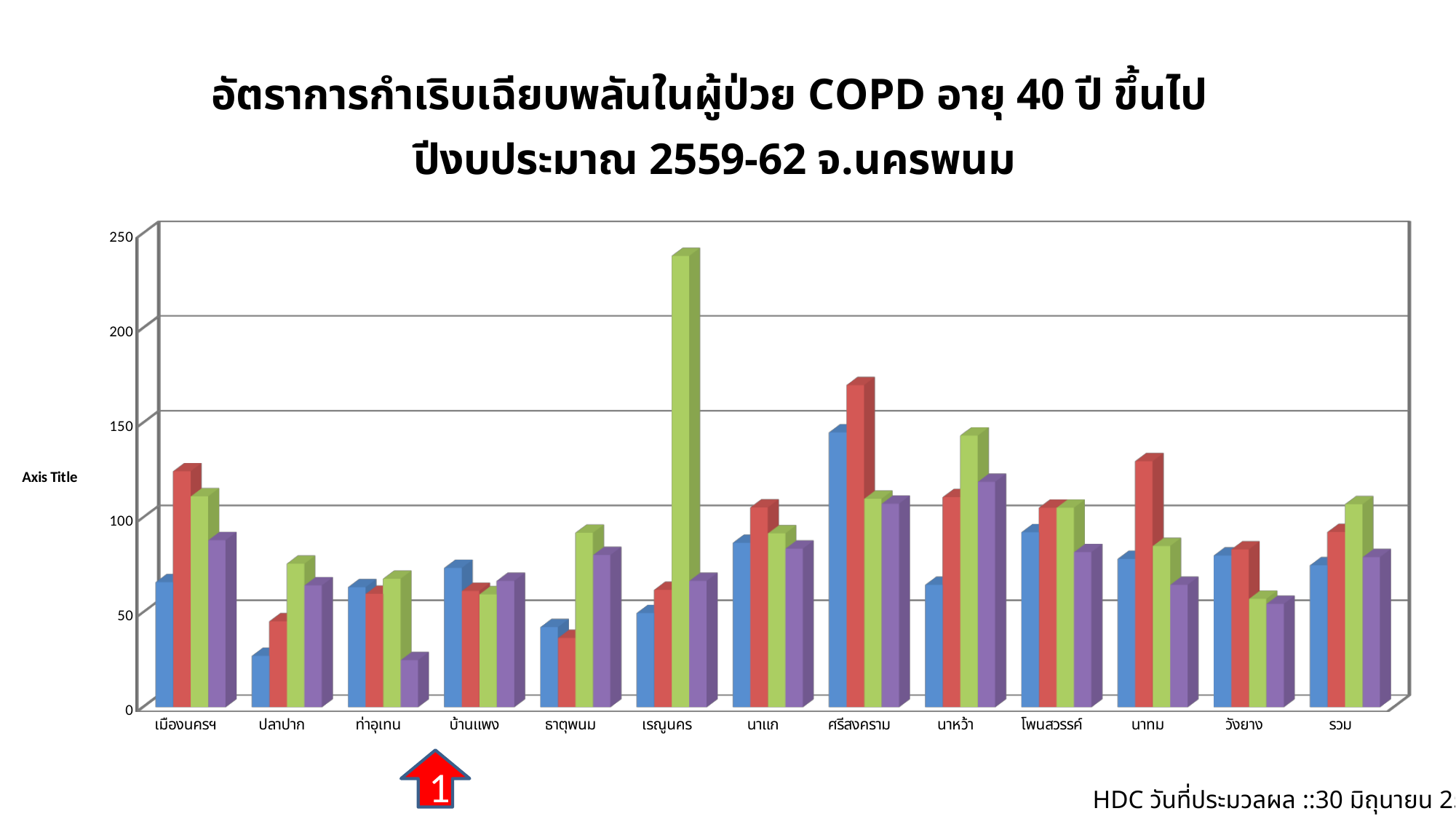
Which category has the tallest bar in the whole chart? เรณูนคร How many categories are shown along the x axis of the chart? 13 Which category has the tallest red bar? ศรีสงคราม Which category does the red arrow labelled 1 below the chart point to? บ้านแพง Is the red bar for นาทม greater or less than 100? greater What kind of chart is shown on the slide? bar chart Is the green bar for เรณูนคร greater or less than 200? greater Is the blue bar for ปลาปาก greater or less than 50? less For ศรีสงคราม, which is larger: the red bar or the green bar? the red bar For ปลาปาก, which is larger: the blue bar or the green bar? the green bar